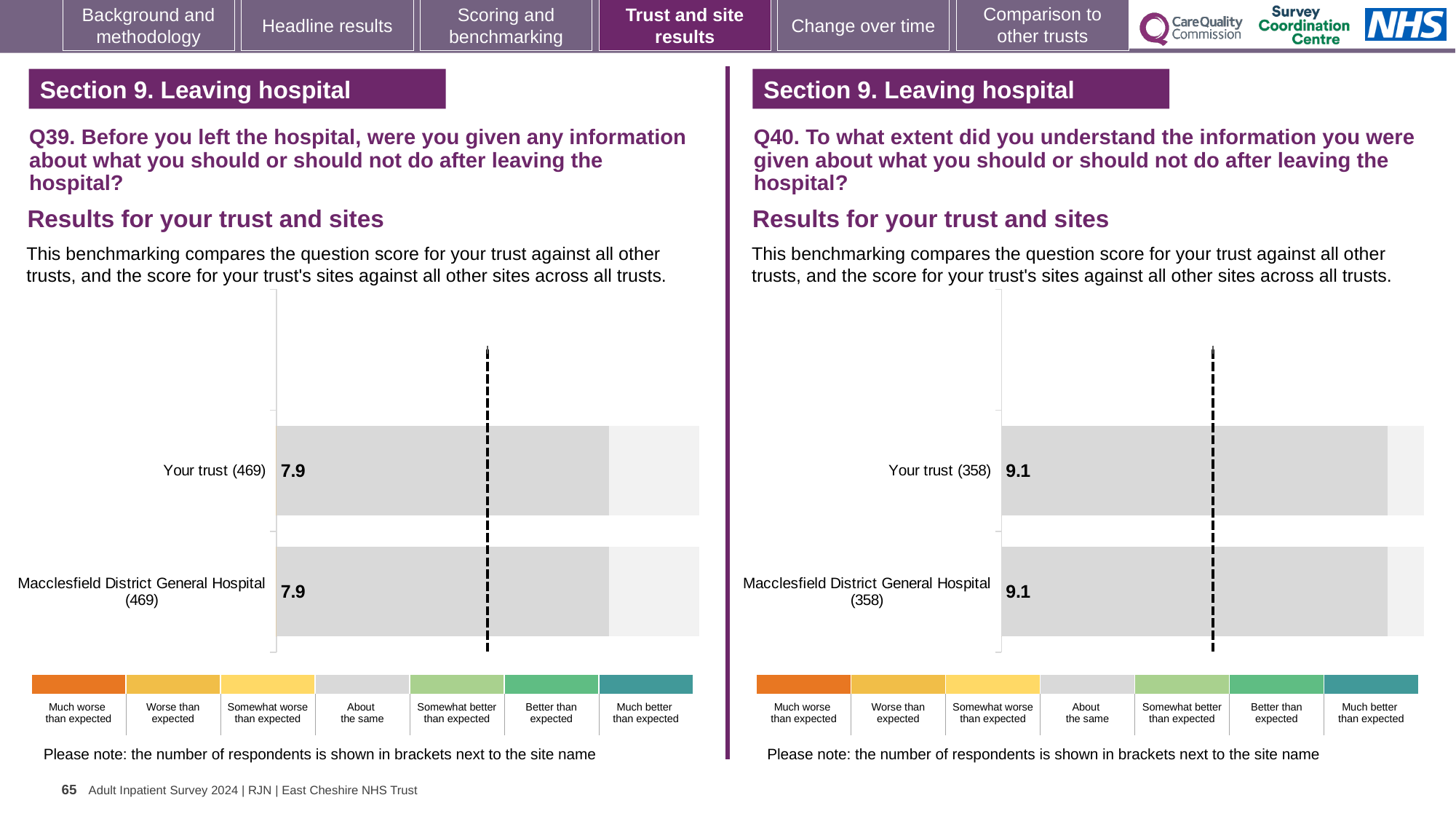
In the Q40 chart on the right, what is the score for Macclesfield District General Hospital? 9.1 How many bars are plotted in the Q40 chart on the right? 2 How many bars are plotted in the Q39 chart on the left? 2 In the Q39 chart on the left, what is the score for Macclesfield District General Hospital? 7.9 In the Q39 chart on the left, how many respondents are shown in brackets next to Your trust? 469 In the Q39 chart on the left, what is the difference between the score for Your trust and the score for Macclesfield District General Hospital? 0 In the Q40 chart on the right, what is the difference between the score for Your trust and the score for Macclesfield District General Hospital? 0 In the Q40 chart on the right, what is the score for Your trust? 9.1 In the Q39 chart on the left, what is the score for Your trust? 7.9 Is the score for Your trust in the Q40 chart on the right larger or smaller than the score for Your trust in the Q39 chart on the left? Larger What kind of chart is used for the Q40 results on the right? Bar chart In the Q40 chart on the right, how many respondents are shown in brackets next to Macclesfield District General Hospital? 358